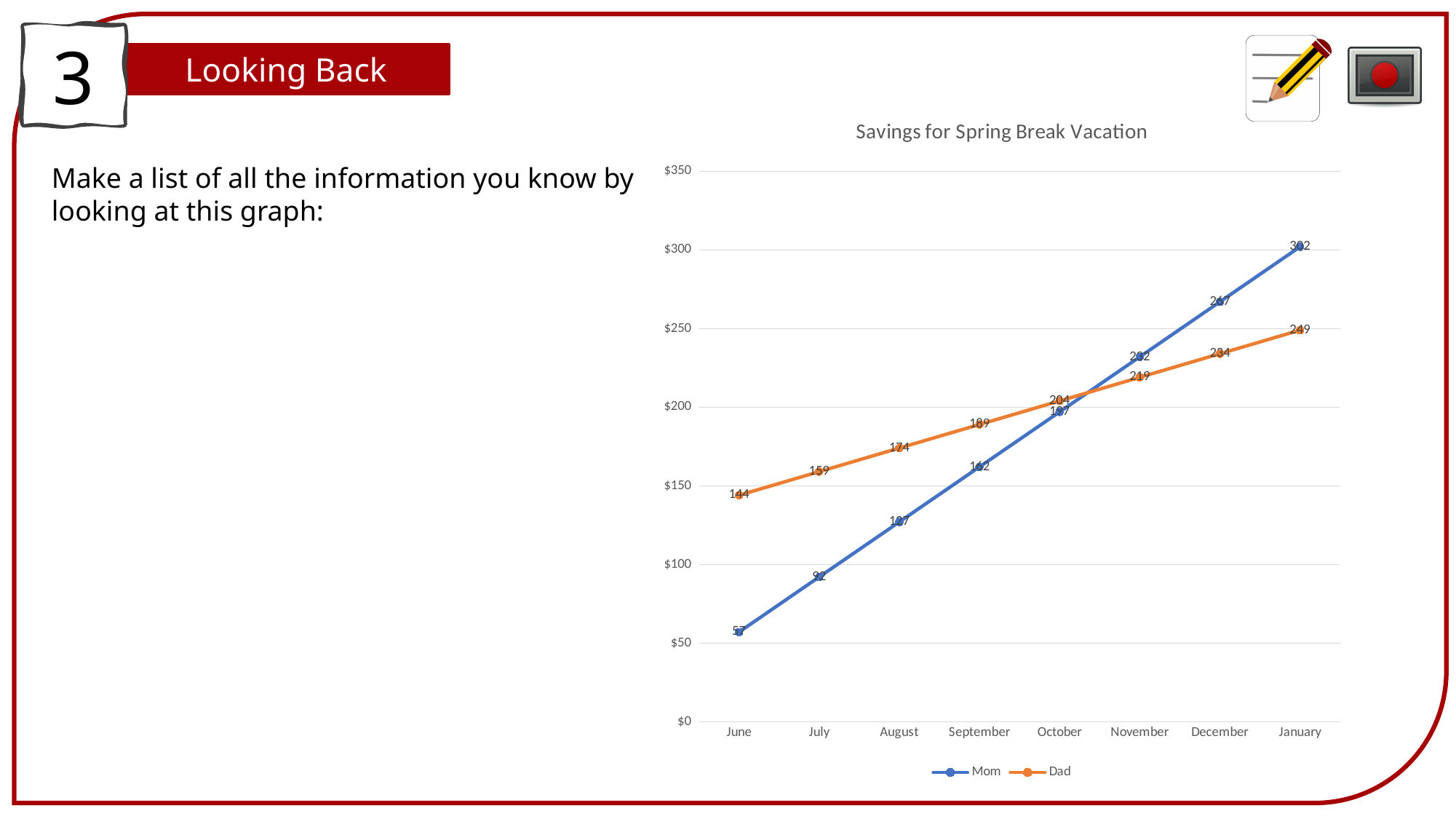
How many series does the legend list? 2 In January, which series has the larger value, Mom or Dad? Mom In which month is the Mom series highest? January In which month is the Dad series lowest? June What is the value for Dad in January? 249 What kind of chart is shown on the slide? Line chart What is the value for Dad in September? 189 What is the difference between Mom's value in January and Mom's value in June? 245 What is the value for Mom in June? 57 In June, which series has the larger value, Mom or Dad? Dad Do the Mom values rise or fall from June to January? Rise How many months are shown on the x axis? 8